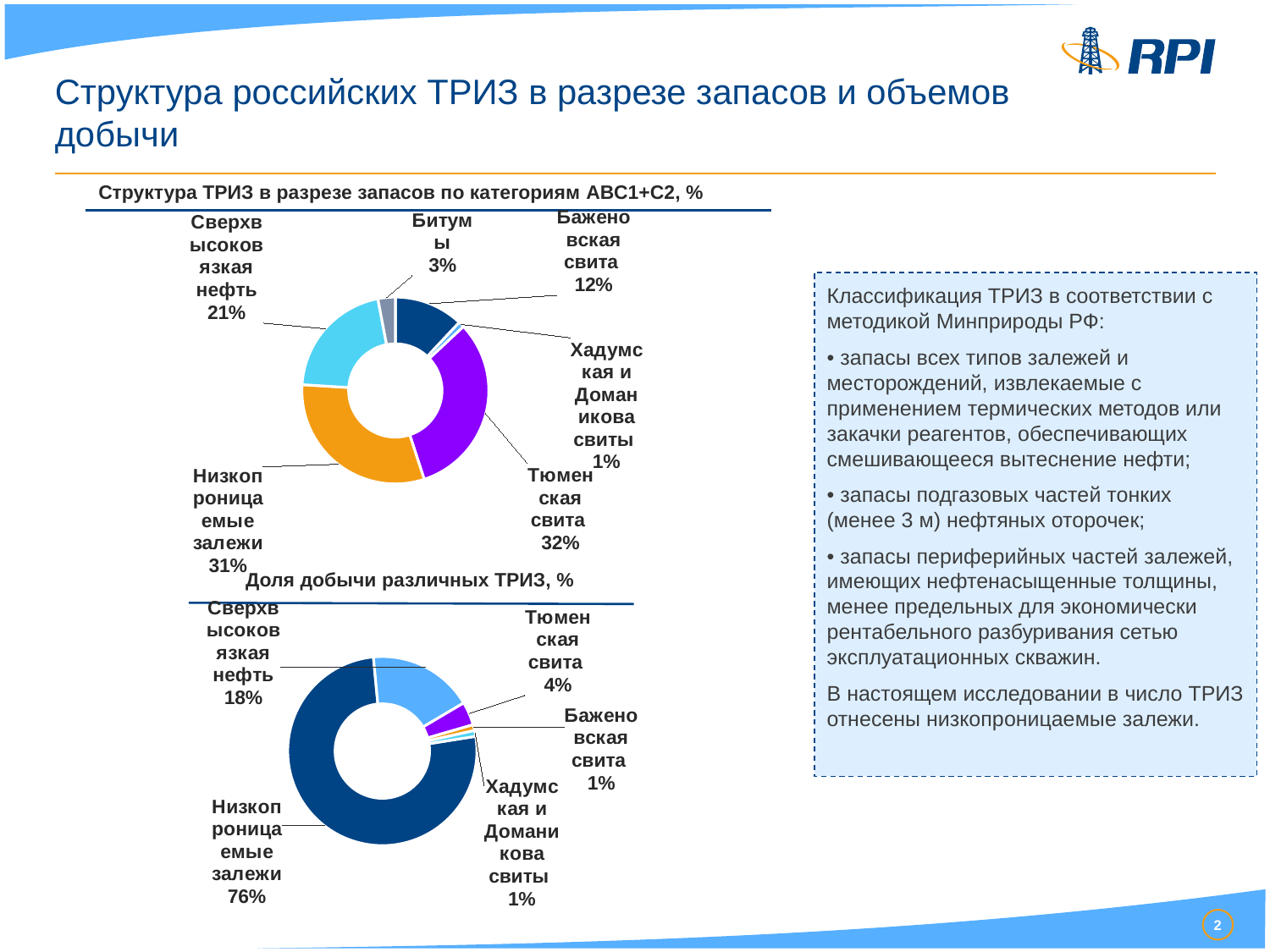
What type of chart is 'Доля добычи различных ТРИЗ, %'? Doughnut (pie) chart In the chart 'Доля добычи различных ТРИЗ, %', which category has the largest share? Низкопроницаемые залежи In the chart 'Структура ТРИЗ в разрезе запасов по категориям АВС1+С2, %', which category has the smallest share? Хадумская и Доманикова свиты In the chart 'Структура ТРИЗ в разрезе запасов по категориям АВС1+С2, %', which category has the largest share? Тюменская свита In the chart 'Структура ТРИЗ в разрезе запасов по категориям АВС1+С2, %', how many categories are shown? 6 In the chart 'Доля добычи различных ТРИЗ, %', what share does Тюменская свита have? 4% In the chart 'Структура ТРИЗ в разрезе запасов по категориям АВС1+С2, %', what is the difference between the shares of Сверхвысоковязкая нефть and Баженовская свита? 9 percentage points In the chart 'Доля добычи различных ТРИЗ, %', how many categories are shown? 5 In the chart 'Структура ТРИЗ в разрезе запасов по категориям АВС1+С2, %', what share does Битумы have? 3% In the chart 'Доля добычи различных ТРИЗ, %', what share does Низкопроницаемые залежи have? 76% In the chart 'Доля добычи различных ТРИЗ, %', which is larger: the share of Сверхвысоковязкая нефть or the share of Тюменская свита? Сверхвысоковязкая нефть In the chart 'Структура ТРИЗ в разрезе запасов по категориям АВС1+С2, %', what share does Тюменская свита have? 32%